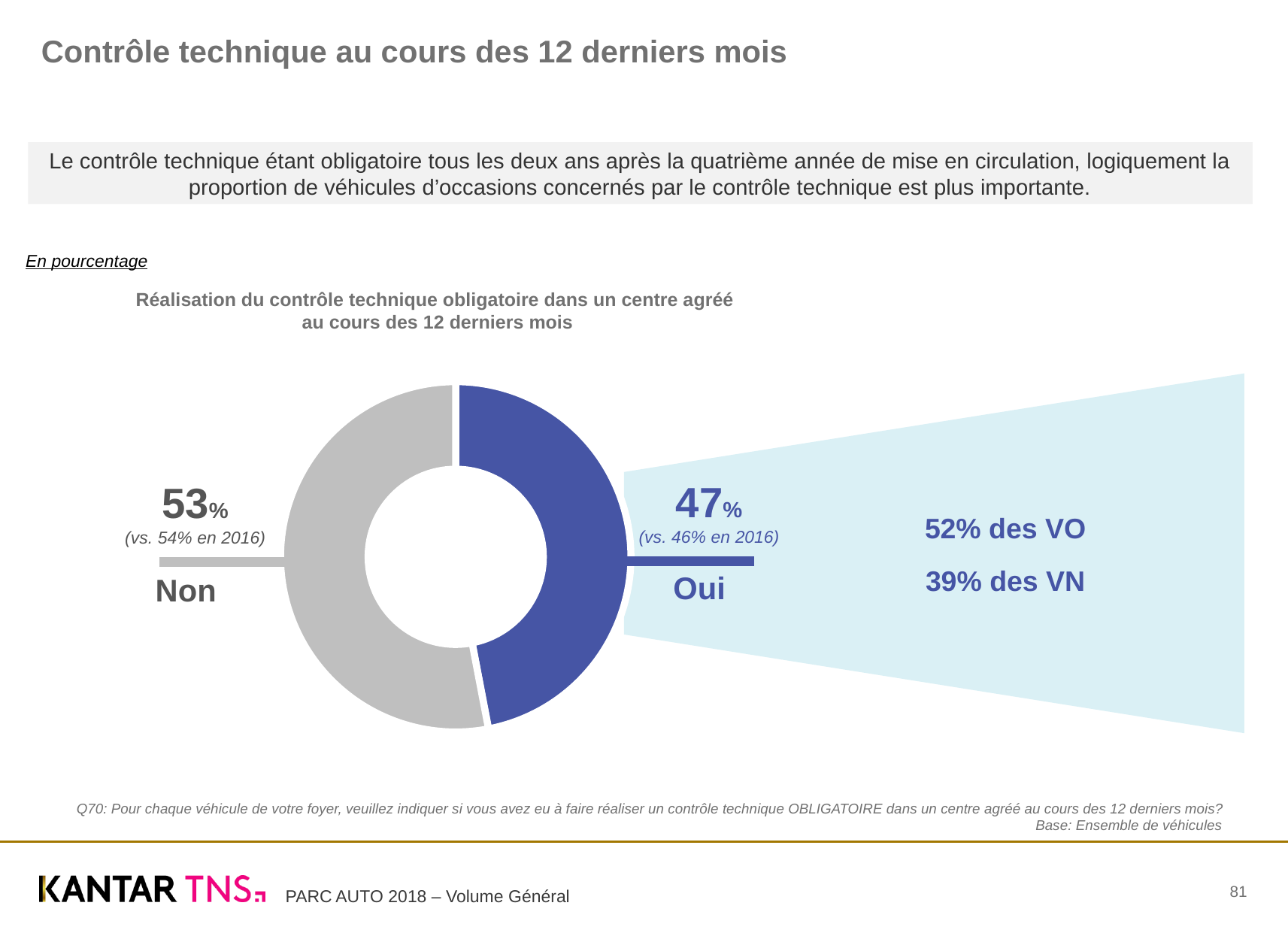
Which category has the smallest share in the chart? Oui What was the value for "Oui" in 2016, according to the chart annotation? 46% What is the difference between the "Non" and "Oui" shares? 6 percentage points Which is larger, the share for "Oui" or the share for "Non"? Non What is the value for "Non" in the chart? 53% According to the callout next to the "Oui" slice, what percentage of VO had a contrôle technique? 52% What was the value for "Non" in 2016, according to the chart annotation? 54% Which category has the largest share in the chart? Non What is the title of the chart? Réalisation du contrôle technique obligatoire dans un centre agréé au cours des 12 derniers mois How many categories does the chart show? 2 What is the value for "Oui" in the chart? 47% What kind of chart is shown on the slide? Doughnut (pie) chart